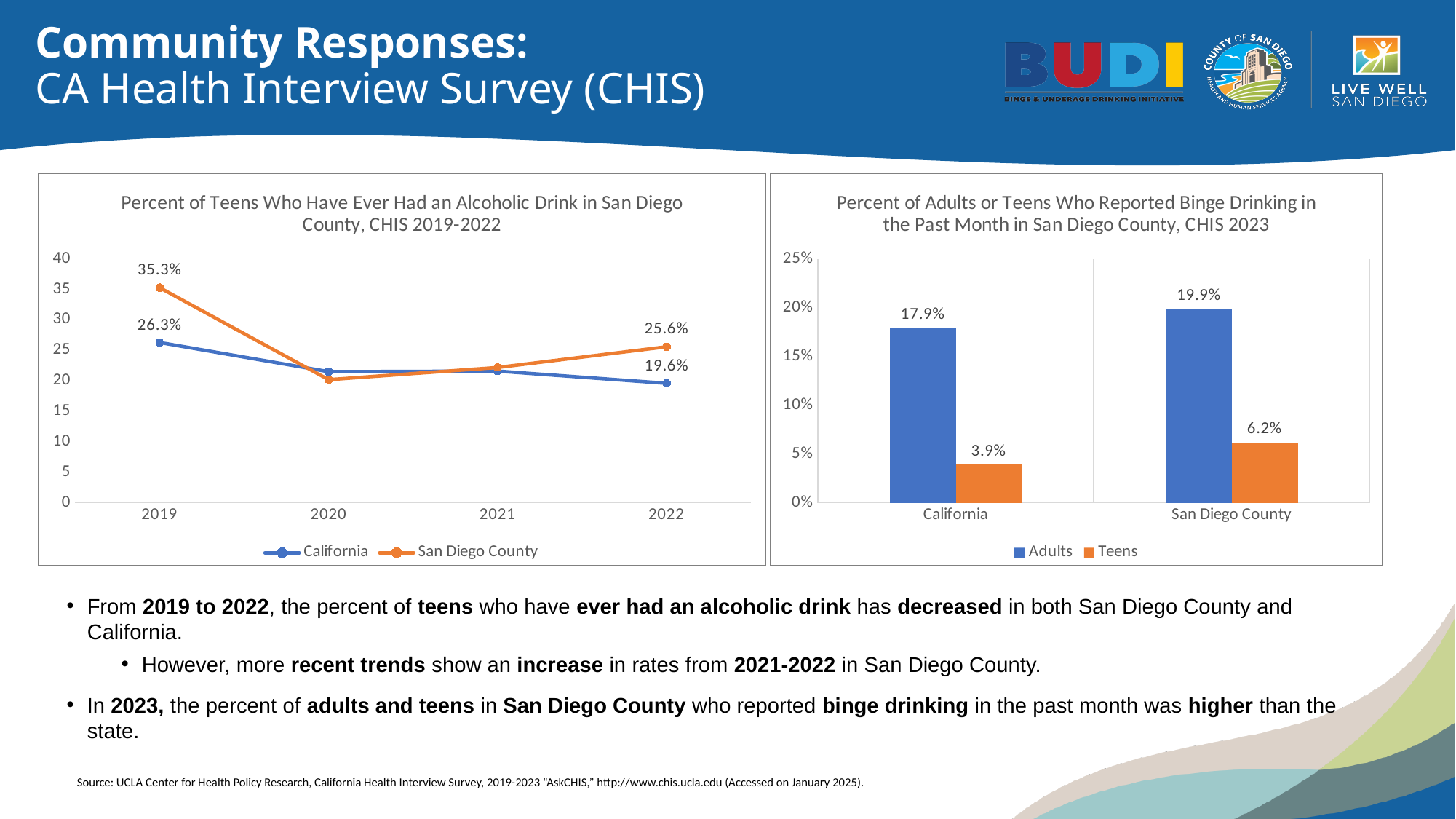
In the chart 'Percent of Teens Who Have Ever Had an Alcoholic Drink in San Diego County, CHIS 2019-2022', what is the value for California in 2022? 19.6% In the left chart, how many years are shown on the x axis? 4 In the left chart, does the California line rise or fall from 2019 to 2022? Fall In the right chart, what is the difference between the Adults value for San Diego County and the Adults value for California? 2.0 percentage points In the chart 'Percent of Adults or Teens Who Reported Binge Drinking in the Past Month in San Diego County, CHIS 2023', what is the value for Teens in San Diego County? 6.2% In the left chart, how much higher was San Diego County than California in 2019? 9.0 percentage points In the left chart, is the value for California in 2020 greater or less than 25? less What kind of chart is the right chart on the slide? Bar chart In the right chart, which bar is the highest? Adults in San Diego County In the chart 'Percent of Teens Who Have Ever Had an Alcoholic Drink in San Diego County, CHIS 2019-2022', what is the value for San Diego County in 2019? 35.3% What kind of chart is the left chart on the slide? Line chart In the left chart, how many series does the legend list? 2